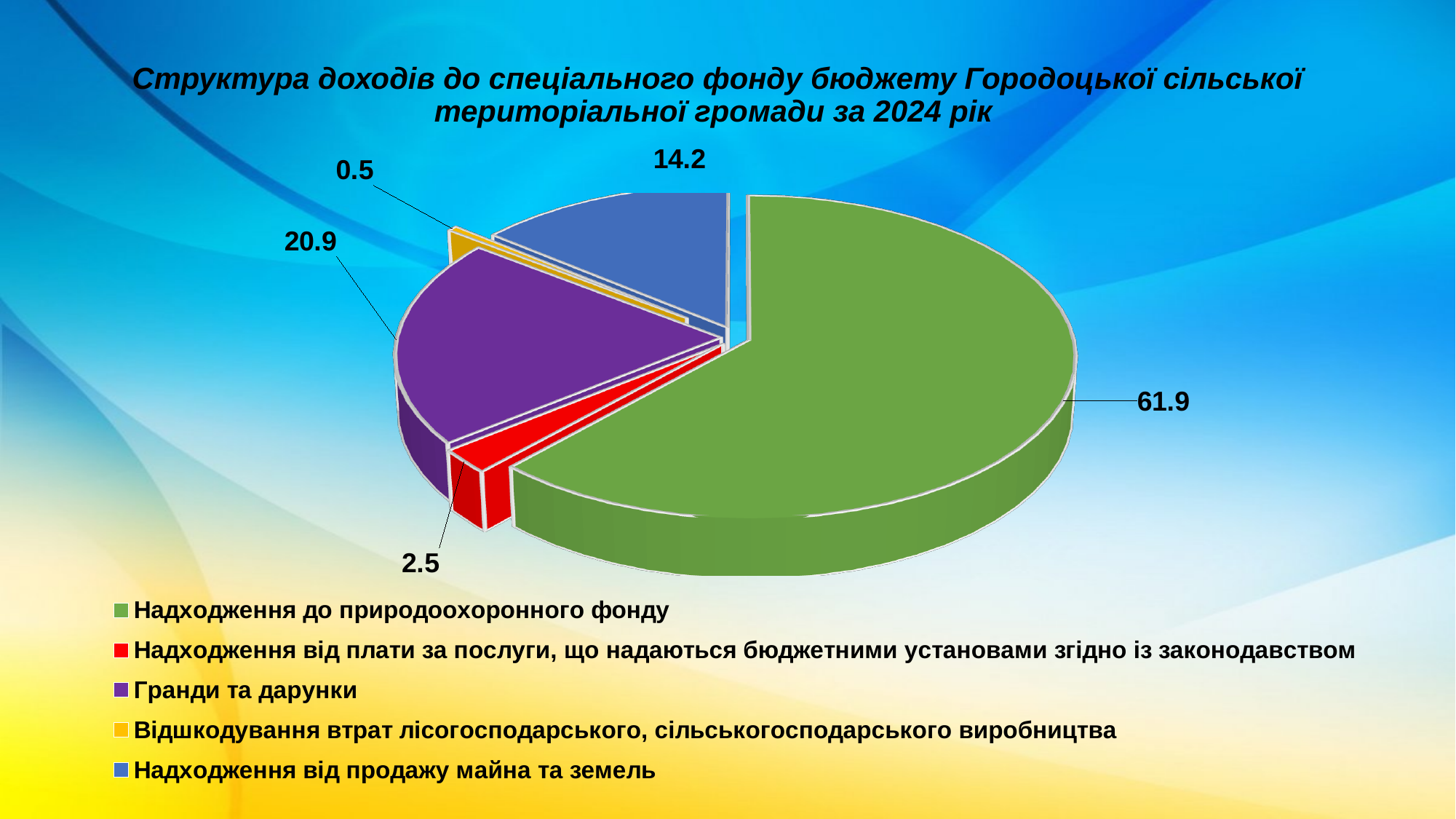
What value is shown for Надходження від продажу майна та земель? 14.2 What value is shown for Гранди та дарунки? 20.9 What value is shown for Надходження до природоохоронного фонду? 61.9 What value is shown for Надходження від плати за послуги, що надаються бюджетними установами згідно із законодавством? 2.5 Which category has the largest slice of the pie? Надходження до природоохоронного фонду What type of chart is shown on the slide? Pie chart Which is larger: the value for Гранди та дарунки or the value for Надходження від продажу майна та земель? Гранди та дарунки Which category has the smallest slice of the pie? Відшкодування втрат лісогосподарського, сільськогосподарського виробництва What is the difference between the values for Гранди та дарунки and Надходження від продажу майна та земель? 6.7 How many slices does the pie chart have? 5 What value is shown for Відшкодування втрат лісогосподарського, сільськогосподарського виробництва? 0.5 Which colour represents Гранди та дарунки in the legend? Purple